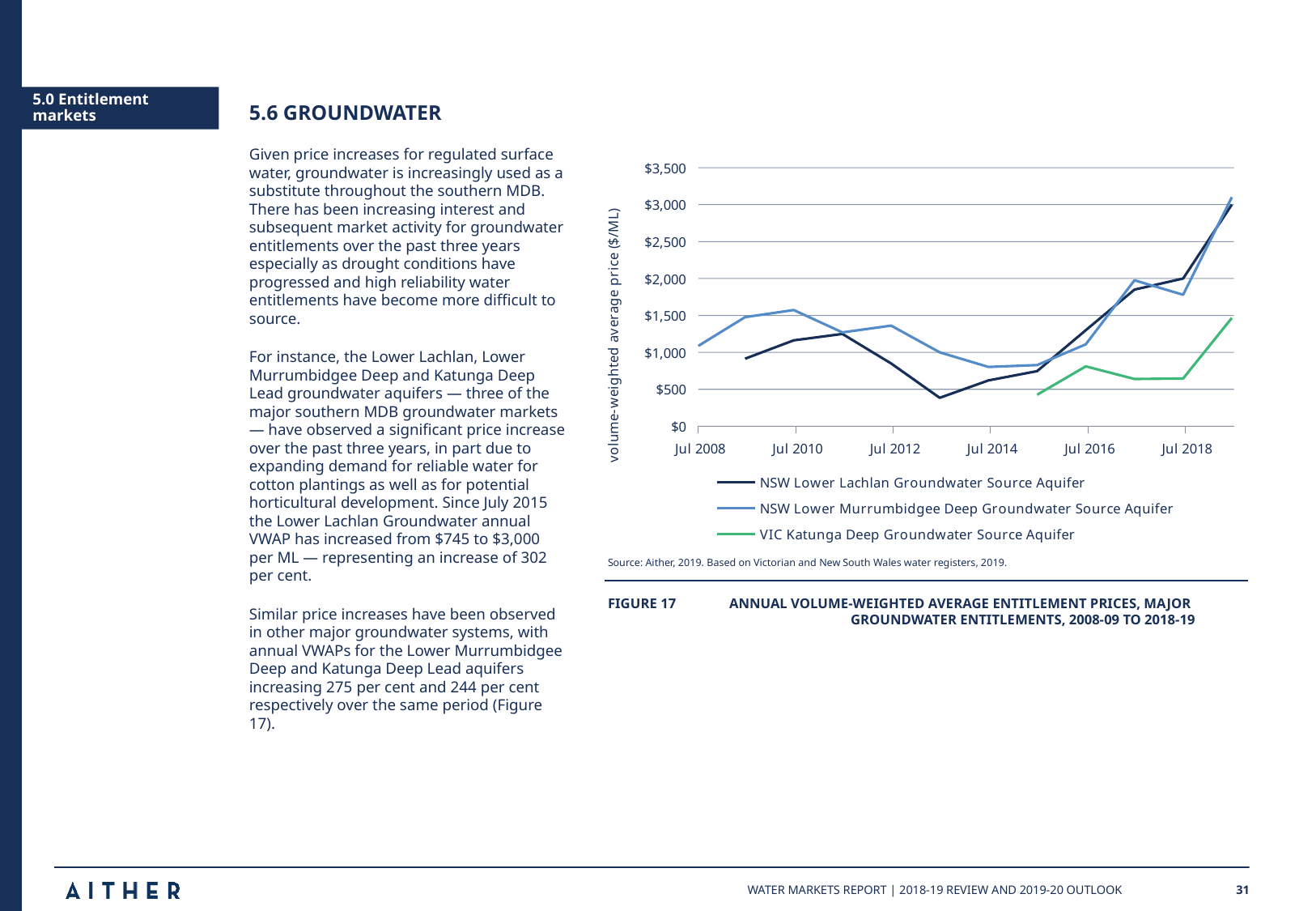
Is the value for NSW Lower Lachlan Groundwater Source Aquifer at Jul 2013 greater or less than $500? less Is the value for NSW Lower Lachlan Groundwater Source Aquifer at Jul 2018 greater or less than $1,500? greater Does the value for NSW Lower Lachlan Groundwater Source Aquifer rise or fall between Jul 2011 and Jul 2013? Fall Which series is drawn in green on the chart? VIC Katunga Deep Groundwater Source Aquifer Which series has the lowest value at Jul 2018? VIC Katunga Deep Groundwater Source Aquifer What is the label on the chart's vertical axis? volume-weighted average price ($/ML) At Jul 2018, which is larger: the value for NSW Lower Lachlan Groundwater Source Aquifer or for VIC Katunga Deep Groundwater Source Aquifer? NSW Lower Lachlan Groundwater Source Aquifer Is the value for NSW Lower Murrumbidgee Deep Groundwater Source Aquifer at Jul 2012 greater or less than $1,000? greater How many series does the chart's legend list? 3 At Jul 2010, which is larger: the value for NSW Lower Murrumbidgee Deep Groundwater Source Aquifer or for NSW Lower Lachlan Groundwater Source Aquifer? NSW Lower Murrumbidgee Deep Groundwater Source Aquifer What kind of chart is shown on the slide? Line chart